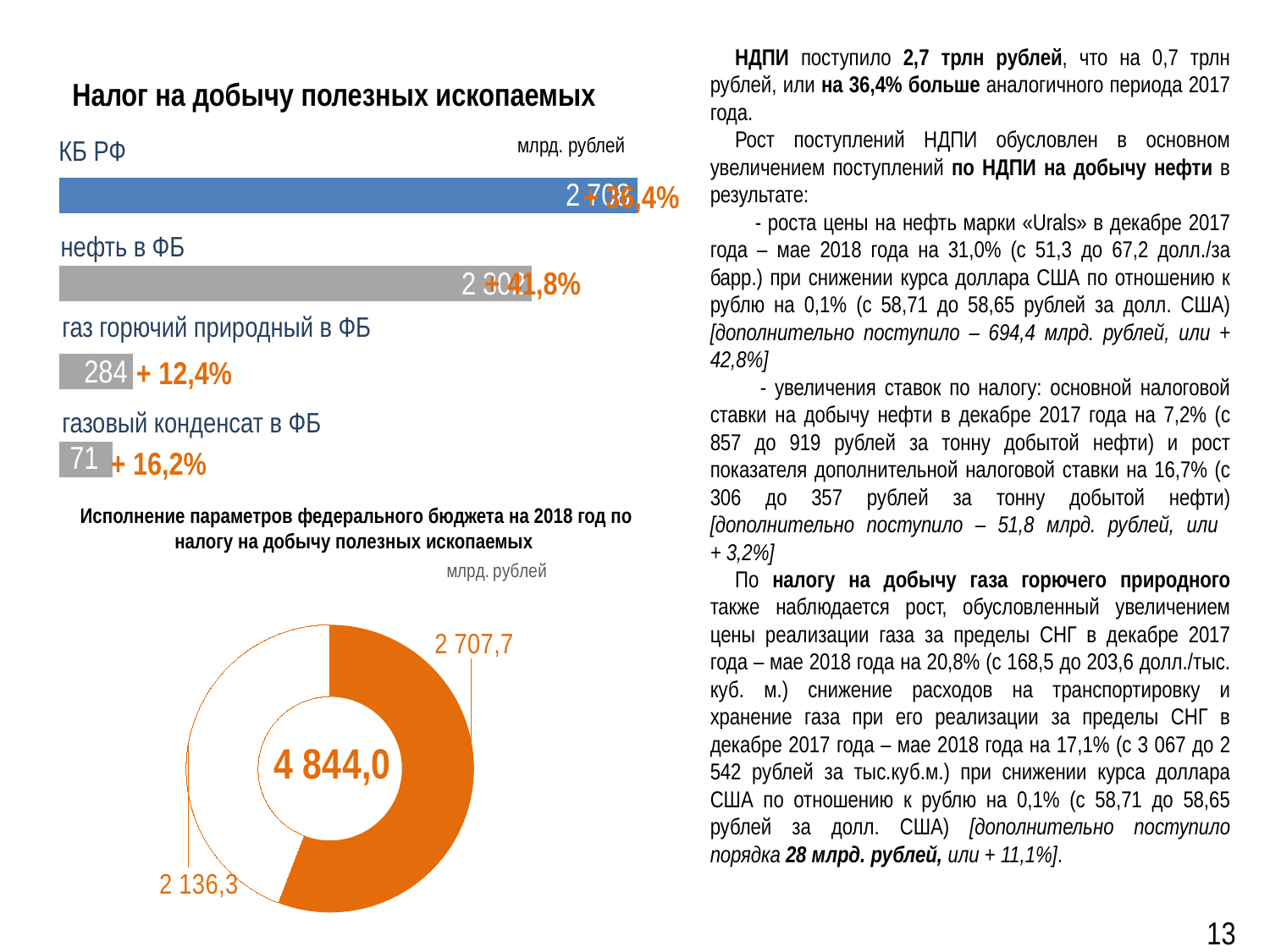
In the bar chart at the top left, which category has the lowest value? газовый конденсат в ФБ What kind of chart is shown at the bottom left of the slide? Doughnut (pie) chart In the bar chart at the top left, what is the difference between the values for 'газ горючий природный в ФБ' and 'газовый конденсат в ФБ'? 213 In the doughnut chart at the bottom left, what is the difference between the two slice values 2 707,7 and 2 136,3? 571,4 In the bar chart at the top left, what is the value for 'газовый конденсат в ФБ'? 71 In the doughnut chart at the bottom left, what total is shown in the centre? 4 844,0 In the bar chart at the top left, what percentage change is shown next to the 'нефть в ФБ' bar? + 41,8% In the doughnut chart at the bottom left, what is the value of the orange slice? 2 707,7 How many slices does the doughnut chart at the bottom left have? 2 In the doughnut chart at the bottom left, what is the value of the white slice? 2 136,3 In the doughnut chart at the bottom left, which slice is larger, the one labelled 2 707,7 or the one labelled 2 136,3? 2 707,7 In the bar chart at the top left, what is the value for 'газ горючий природный в ФБ'? 284